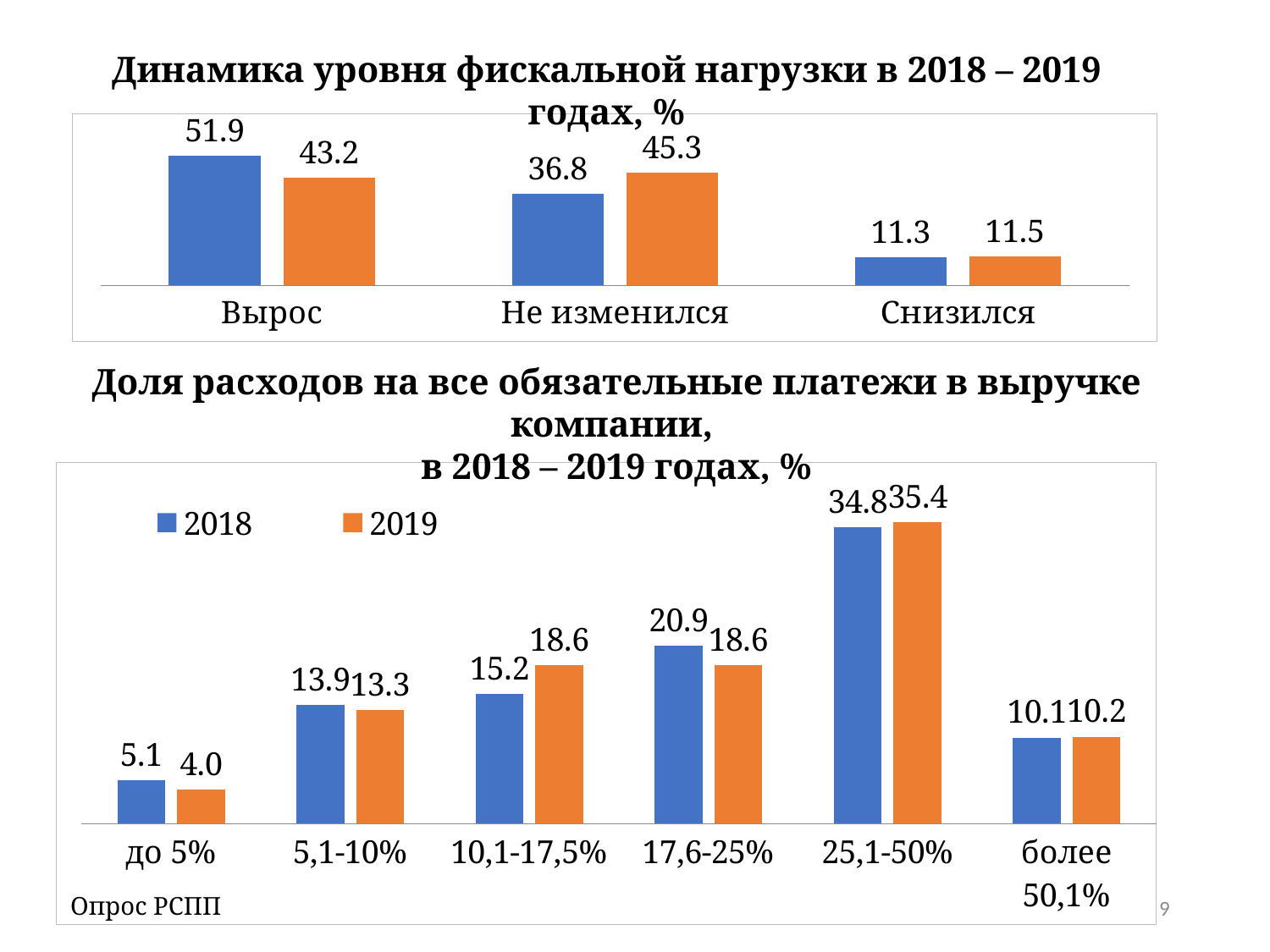
In the top chart (Динамика уровня фискальной нагрузки), what is the value of the orange bar for Не изменился? 45.3 In the top chart (Динамика уровня фискальной нагрузки), what is the value of the blue bar for Вырос? 51.9 In the top chart (Динамика уровня фискальной нагрузки), which category has the lowest values? Снизился In the top chart (Динамика уровня фискальной нагрузки), what is the difference between the blue and orange bars for Вырос? 8.7 What type of chart is the bottom chart (Доля расходов на все обязательные платежи)? Bar chart In the top chart (Динамика уровня фискальной нагрузки), how many categories are shown on the x axis? 3 In the bottom chart (Доля расходов на все обязательные платежи), what is the difference between the 2018 and 2019 values for 10,1-17,5%? 3.4 In the bottom chart (Доля расходов на все обязательные платежи), which is larger for 10,1-17,5%: the 2018 value or the 2019 value? 2019 In the bottom chart (Доля расходов на все обязательные платежи), how many series does the legend list? 2 In the bottom chart (Доля расходов на все обязательные платежи), what is the 2018 value for 17,6-25%? 20.9 In the bottom chart (Доля расходов на все обязательные платежи), which category has the highest 2019 value? 25,1-50% In the bottom chart (Доля расходов на все обязательные платежи), what is the 2019 value for до 5%? 4.0